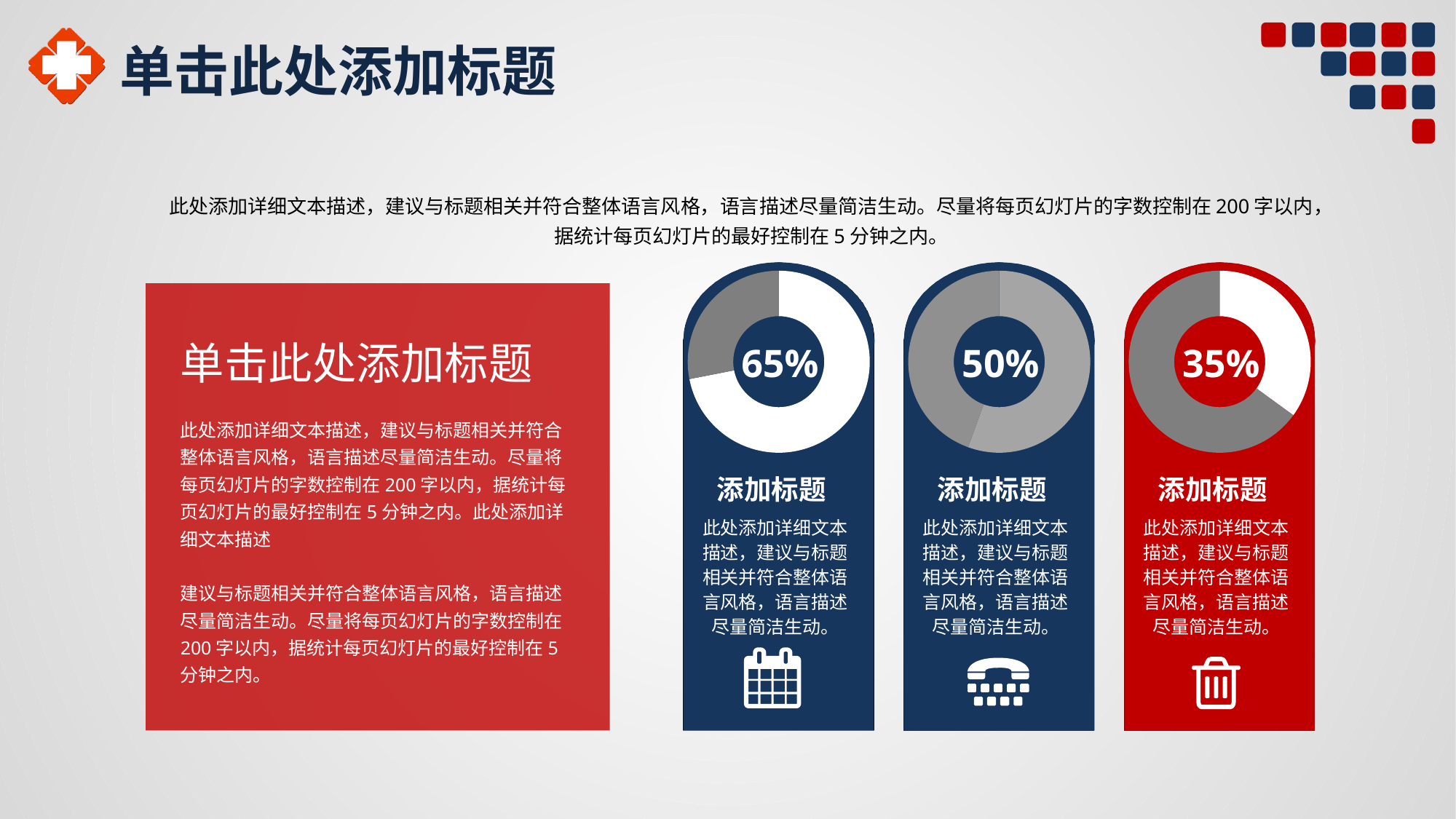
Do the percentages in the donut charts rise or fall from left to right across the slide? fall How many donut charts are on the slide? 3 What value is shown in the centre of the middle donut chart? 50% What value is shown in the centre of the right donut chart? 35% Which of the three donut charts shows the highest percentage: left, middle or right? left What kind of chart is used for the three percentage figures on the slide? donut chart What is the difference between the percentage in the left donut chart and the percentage in the right donut chart? 30% What value is shown in the centre of the left donut chart? 65% Is the percentage in the middle donut chart larger or smaller than the percentage in the right donut chart? larger Which of the three donut charts shows the lowest percentage: left, middle or right? right What colour is the background of the card containing the 35% donut chart? red What is the difference between the percentage in the left donut chart and the percentage in the middle donut chart? 15%